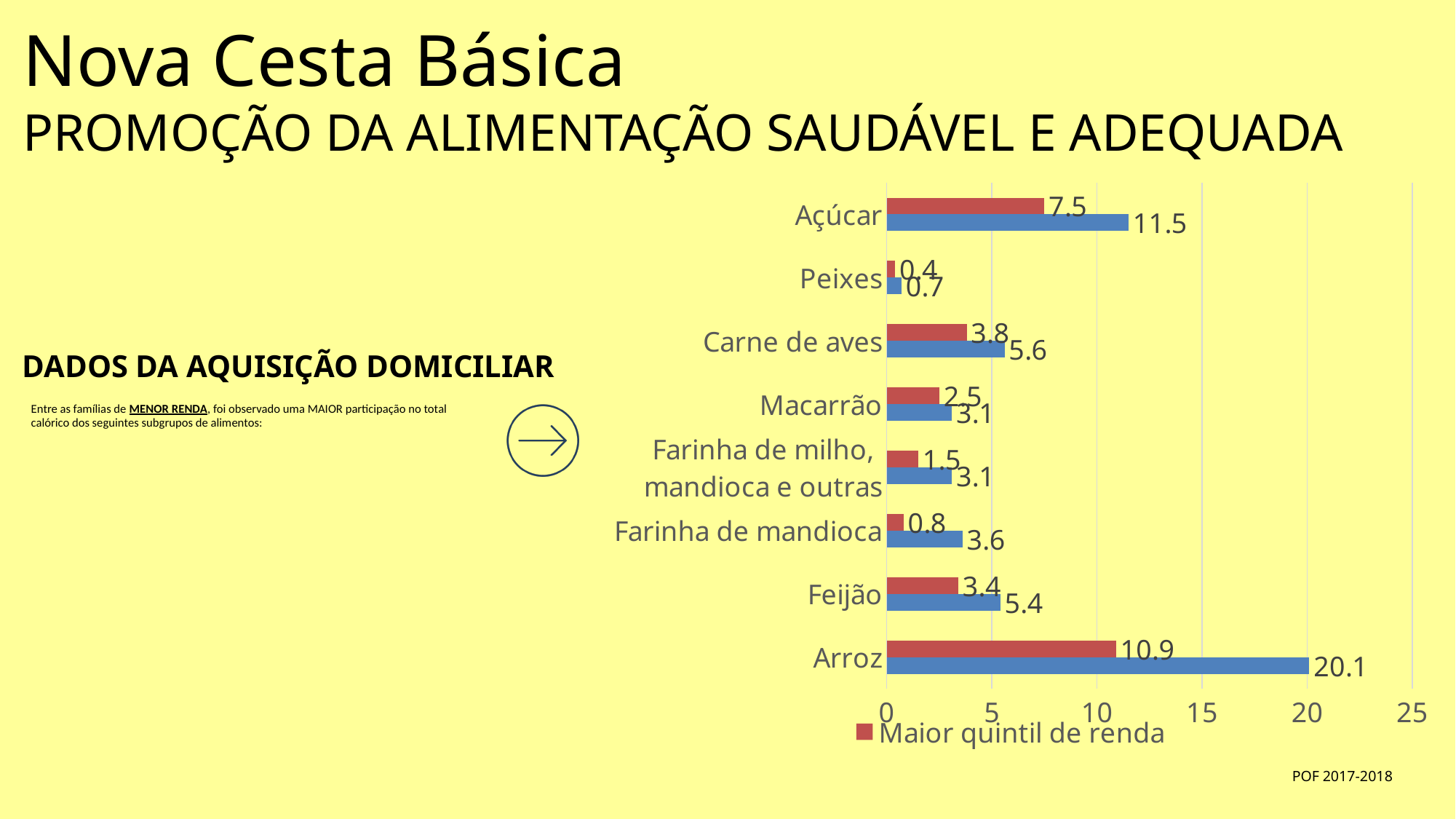
What is the value of the blue bar for Arroz? 20.1 Which category has the highest blue bar value? Arroz What kind of chart is shown on the slide? bar chart Which is larger: the blue bar for Feijão or the blue bar for Carne de aves? Carne de aves What series name is shown in the chart legend? Maior quintil de renda What is the difference between the blue bar and the red bar for Açúcar? 4.0 What is the value of the 'Maior quintil de renda' (red) bar for Açúcar? 7.5 How many food categories are shown on the chart? 8 What is the value of the 'Maior quintil de renda' (red) bar for Arroz? 10.9 What is the value of the blue bar for Farinha de mandioca? 3.6 Is the blue bar value for Arroz greater or less than 15? greater Which category has the lowest 'Maior quintil de renda' (red) value? Peixes